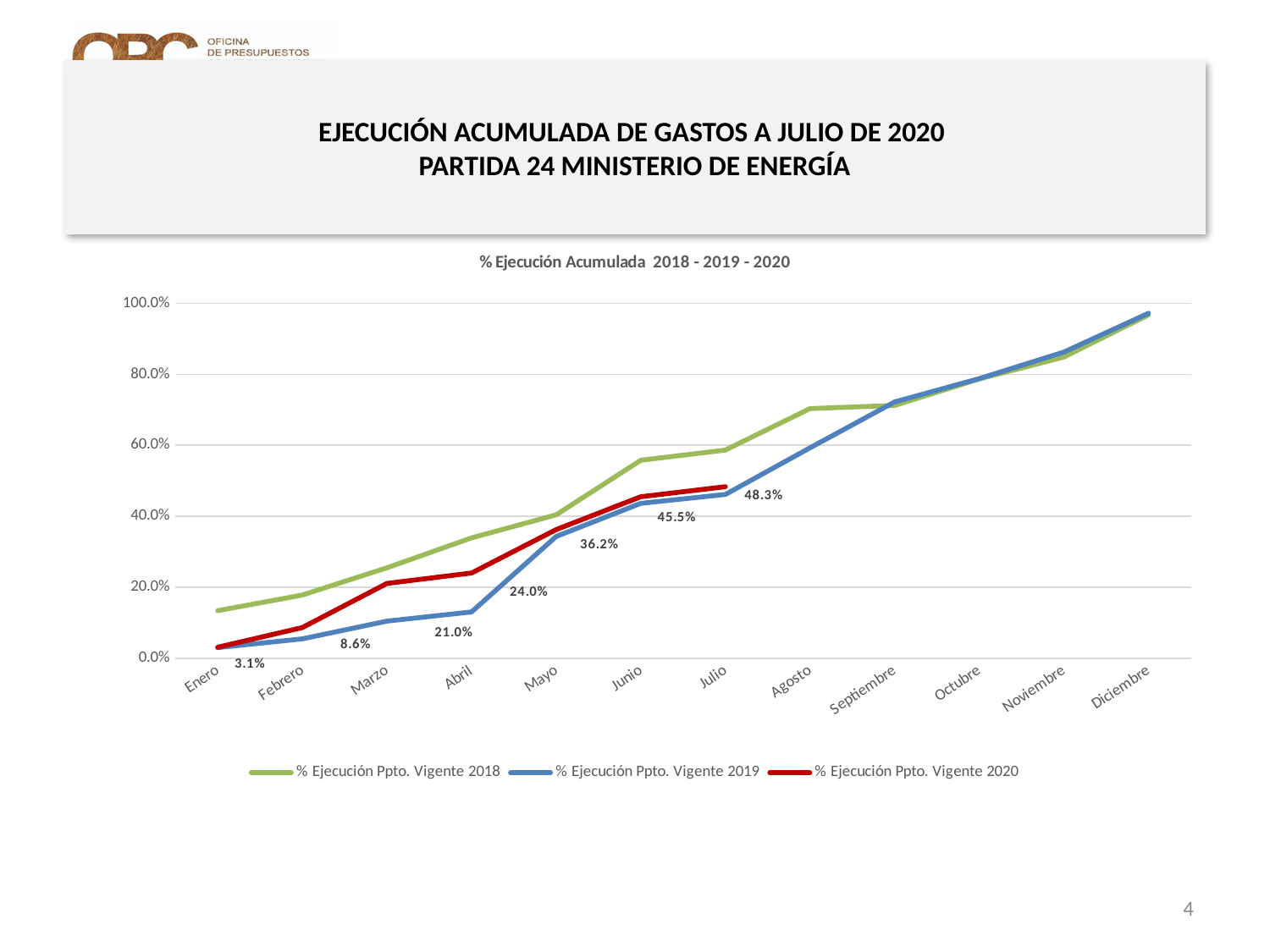
What is the difference between the 2020 values for Julio and Junio? 2.8% Is the value for % Ejecución Ppto. Vigente 2018 in Agosto greater or less than 60.0%? greater How many months are shown on the x axis? 12 What is the value for % Ejecución Ppto. Vigente 2020 in Enero? 3.1% How many series does the legend list? 3 What is the value for % Ejecución Ppto. Vigente 2020 in Mayo? 36.2% What is the value for % Ejecución Ppto. Vigente 2020 in Julio? 48.3% What is the value for % Ejecución Ppto. Vigente 2020 in Marzo? 21.0% Which month has the lowest labelled value for % Ejecución Ppto. Vigente 2020? Enero Which is larger for the 2020 series: the value in Abril or the value in Febrero? Abril What kind of chart is shown on the slide? Line chart Do the values for % Ejecución Ppto. Vigente 2019 rise or fall from Enero to Diciembre? Rise